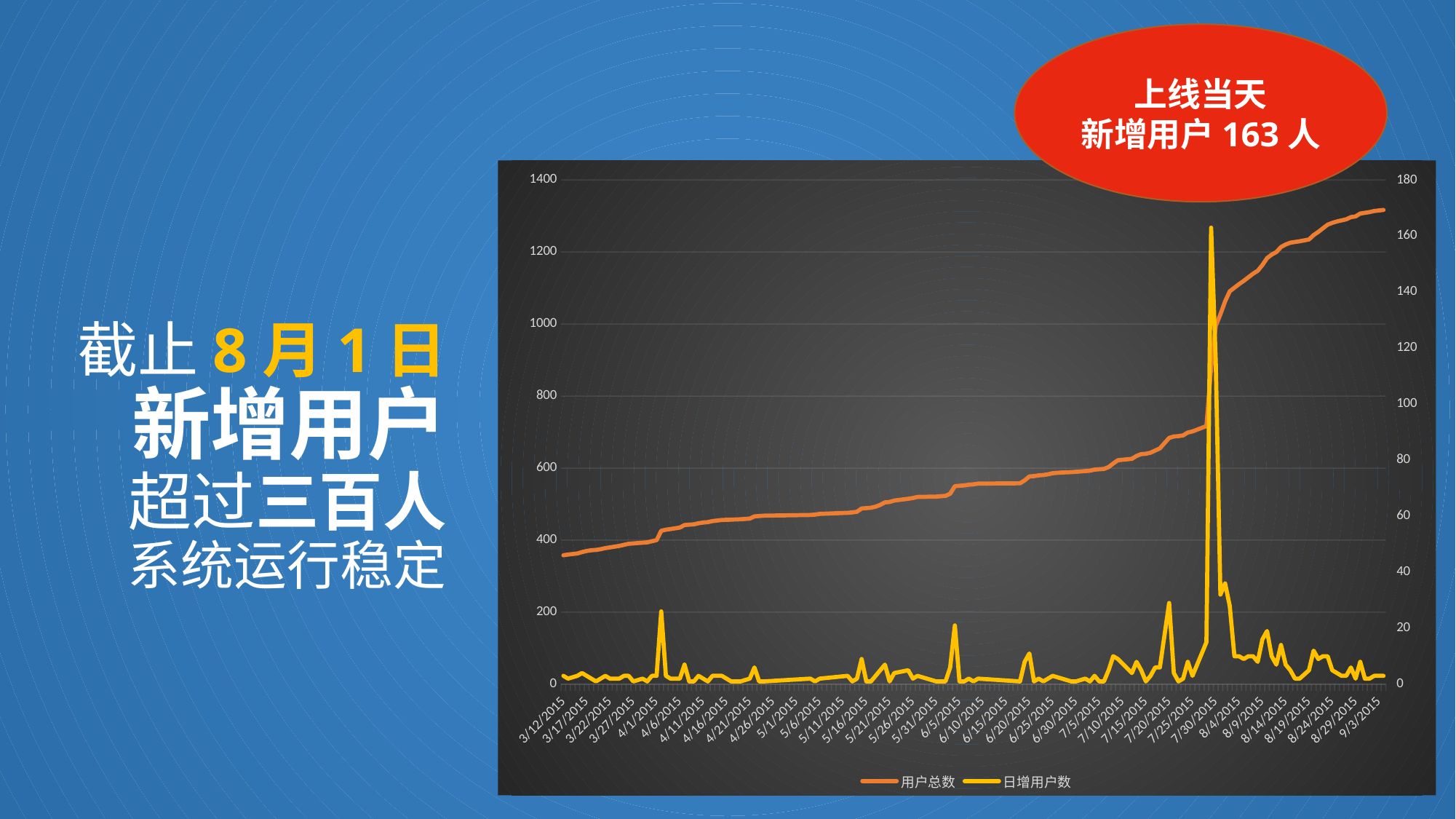
What is the highest tick value shown on the right-hand vertical axis? 180 Is the value of 用户总数 at 3/12/2015 greater or less than 400? less Is the value of 用户总数 at 5/1/2015 greater or less than 600? less How many series does the chart legend list? 2 What are the two series named in the chart legend? 用户总数 and 日增用户数 Does the 用户总数 series rise or fall from 3/12/2015 to 9/3/2015? rise Is the value of 用户总数 at 9/3/2015 greater or less than 1200? greater What kind of chart is shown on the slide? line chart According to the callout on the slide, how many new users were added on launch day (上线当天)? 163 人 Which is larger, the 用户总数 value at 8/29/2015 or at 3/12/2015? 8/29/2015